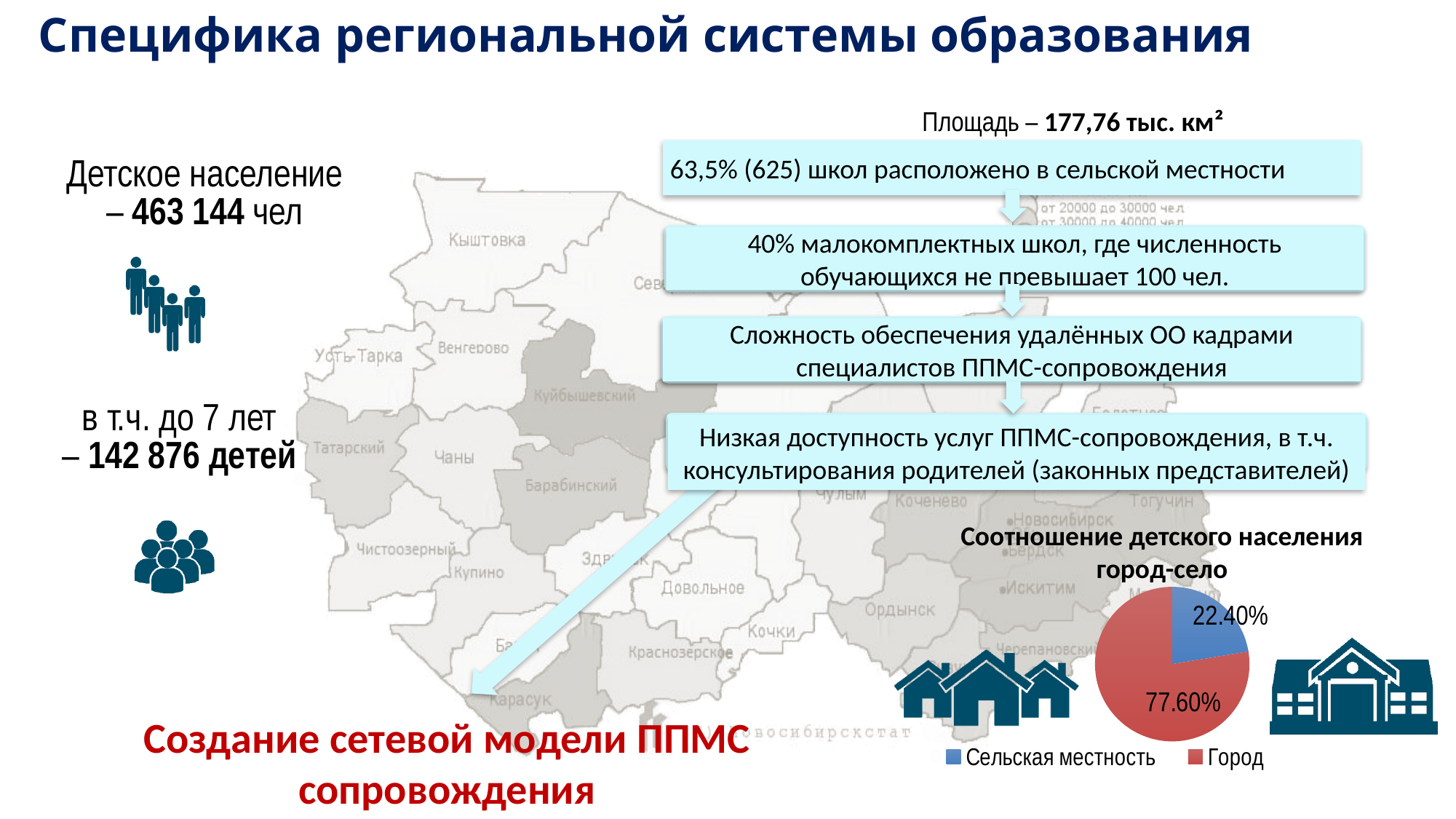
Which is larger in the pie chart, Город or Сельская местность? Город What is the title of the pie chart? Соотношение детского населения город-село Which slice of the pie chart is the smallest? Сельская местность How many entries does the pie chart legend list? 2 What kind of chart is shown on the slide? pie chart What share of the pie chart is labelled Город? 77.60% Which slice of the pie chart is the largest? Город What share of the pie chart is labelled Сельская местность? 22.40% What colour is the Сельская местность slice in the pie chart? blue What is the difference between the Город and Сельская местность shares in the pie chart? 55.20% How many slices does the pie chart have? 2